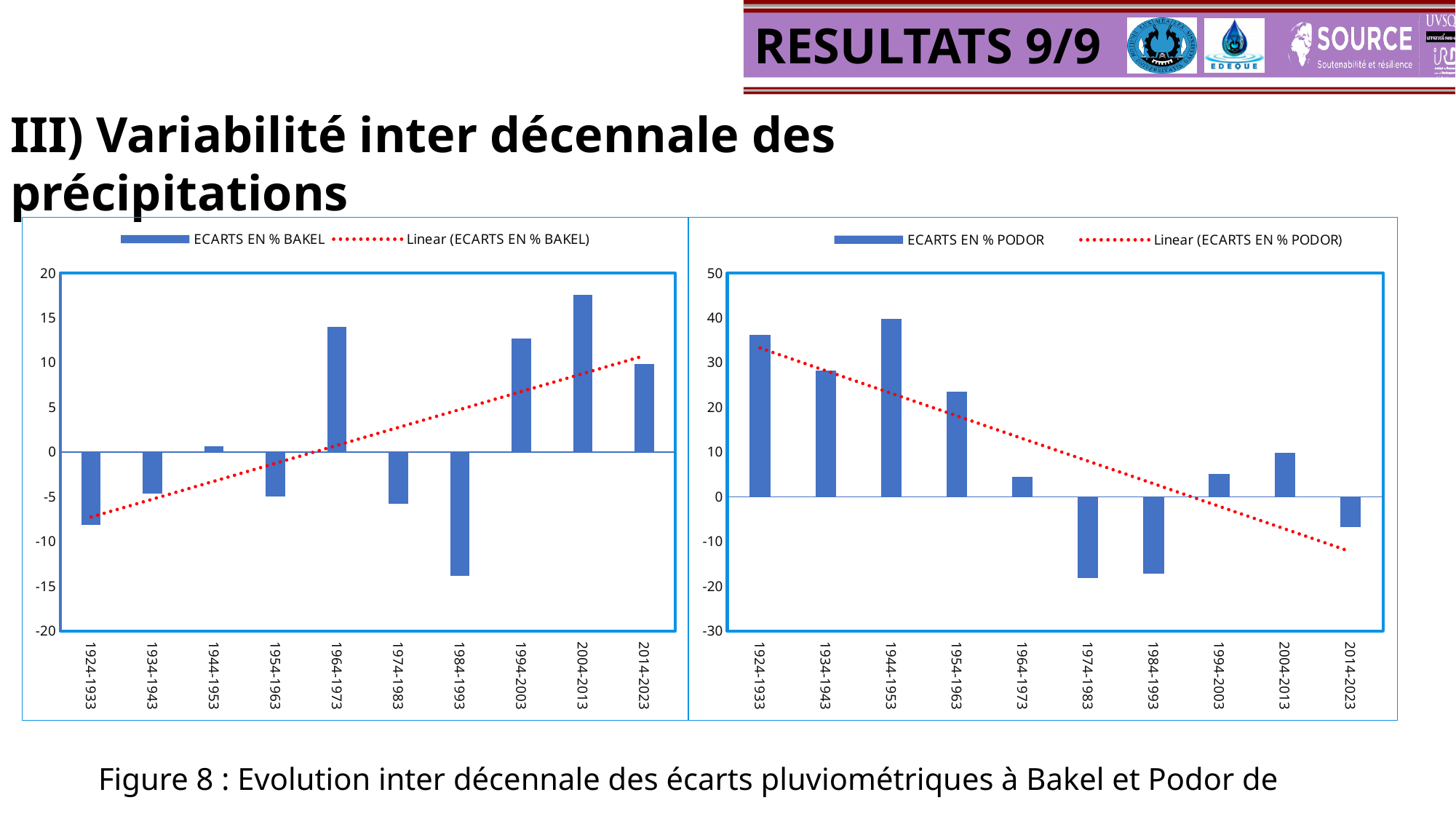
In the ECARTS EN % PODOR chart, which is larger, the value for 1924-1933 or the value for 1934-1943? 1924-1933 In the ECARTS EN % PODOR chart, is the value for 1974-1983 greater or less than -10? less In the ECARTS EN % BAKEL chart, is the value for 1984-1993 greater or less than -10? less In the ECARTS EN % PODOR chart, does the dotted linear trend line rise or fall from left to right? Fall In the ECARTS EN % BAKEL chart, is the value for 1964-1973 greater or less than 10? greater In the ECARTS EN % BAKEL chart, which decade has the highest bar? 2004-2013 How many decades are shown on the x axis of the ECARTS EN % PODOR chart? 10 In the ECARTS EN % BAKEL chart, which decade has the lowest bar? 1984-1993 What kind of chart is the ECARTS EN % BAKEL chart? Bar chart In the ECARTS EN % BAKEL chart, which is larger, the value for 2004-2013 or the value for 1964-1973? 2004-2013 In the ECARTS EN % PODOR chart, which decade has the highest bar? 1944-1953